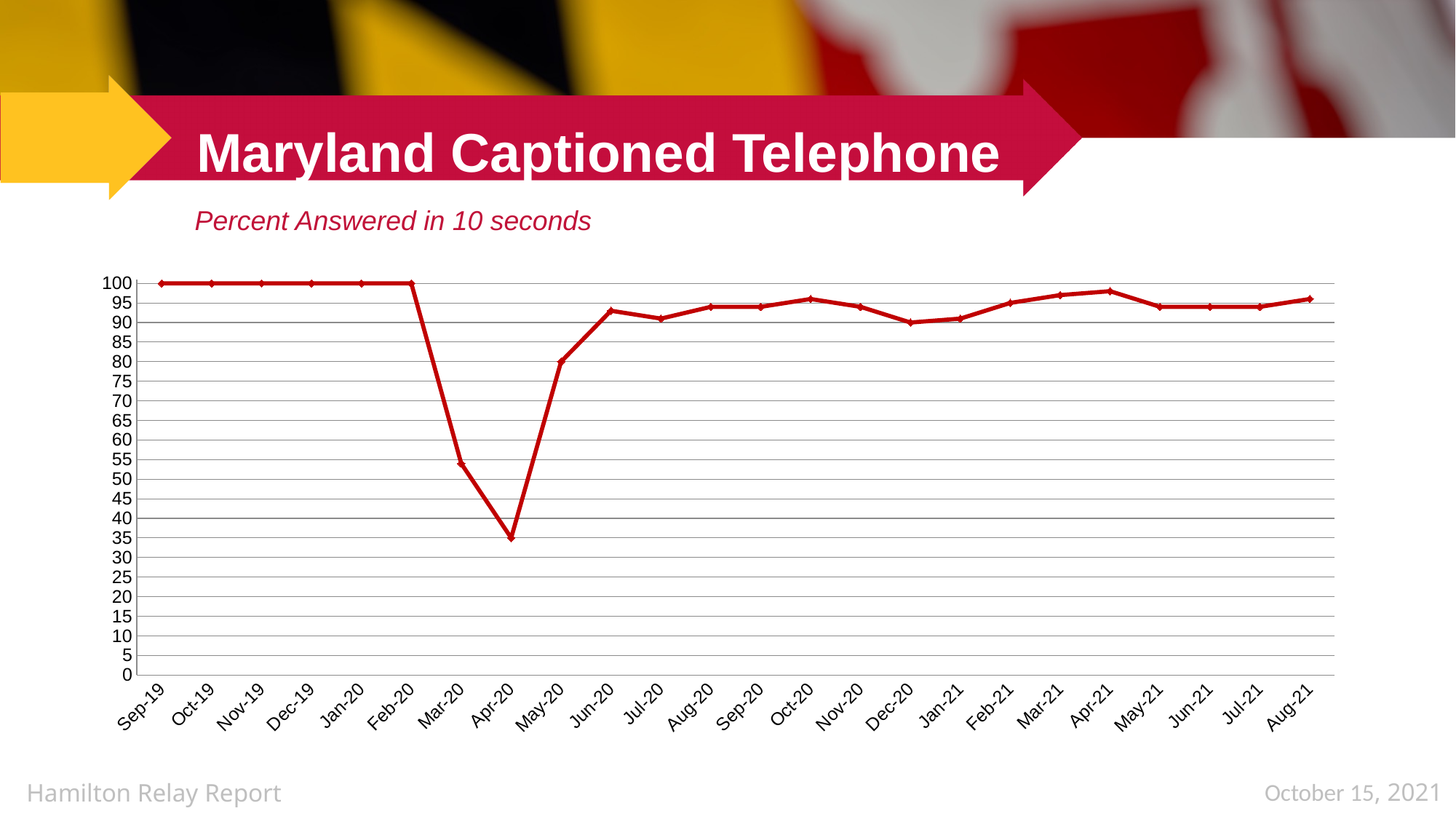
Which month has the lowest value? Apr-20 Do the values rise or fall from Feb-20 to Apr-20? fall How many months are plotted on the x axis? 24 What kind of chart is shown on the slide? line chart What is the difference between the value for Sep-19 and the value for Apr-20? 65 What is the value for Sep-19? 100 What is the value for Apr-20? 35 What is the value for May-20? 80 Which is larger, the value for Apr-20 or the value for May-20? May-20 What is the value for Dec-20? 90 Is the value for Jul-20 greater or less than 95? less Is the value for Mar-20 greater or less than 50? greater